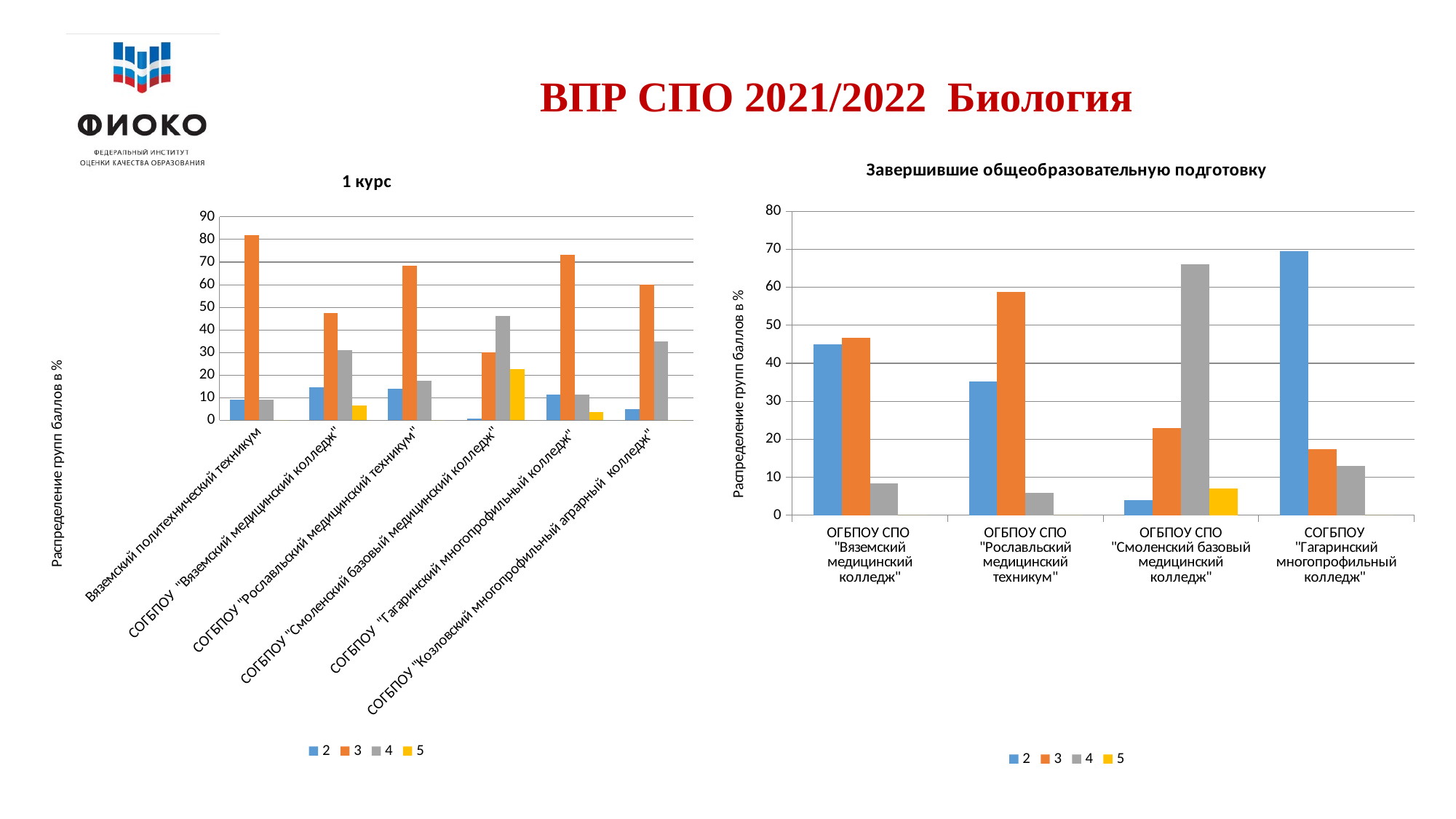
In the chart titled "Завершившие общеобразовательную подготовку", which institution has the highest value for series 2? СОГБПОУ "Гагаринский многопрофильный колледж" In the chart titled "1 курс", for СОГБПОУ "Смоленский базовый медицинский колледж", which series has the larger value: 3 or 4? 4 In the chart titled "1 курс", which institution has the highest value for series 3? Вяземский политехнический техникум In the chart titled "Завершившие общеобразовательную подготовку", for ОГБПОУ СПО "Рославльский медицинский техникум", which series has the larger value: 2 or 3? 3 In the chart titled "1 курс", how many series does the legend list? 4 In the chart titled "Завершившие общеобразовательную подготовку", is the value of series 4 for ОГБПОУ СПО "Смоленский базовый медицинский колледж" greater or less than 60? greater In the chart titled "Завершившие общеобразовательную подготовку", what is the label of the vertical axis? Распределение групп баллов в % In the chart titled "Завершившие общеобразовательную подготовку", how many institutions are shown on the x axis? 4 What kind of chart is the chart titled "1 курс"? bar chart In the chart titled "1 курс", is the value of series 3 for Вяземский политехнический техникум greater or less than 70? greater In the chart titled "1 курс", how many categories (institutions) are shown on the x axis? 6 In the chart titled "1 курс", is the value of series 4 for СОГБПОУ "Смоленский базовый медицинский колледж" greater or less than 40? greater